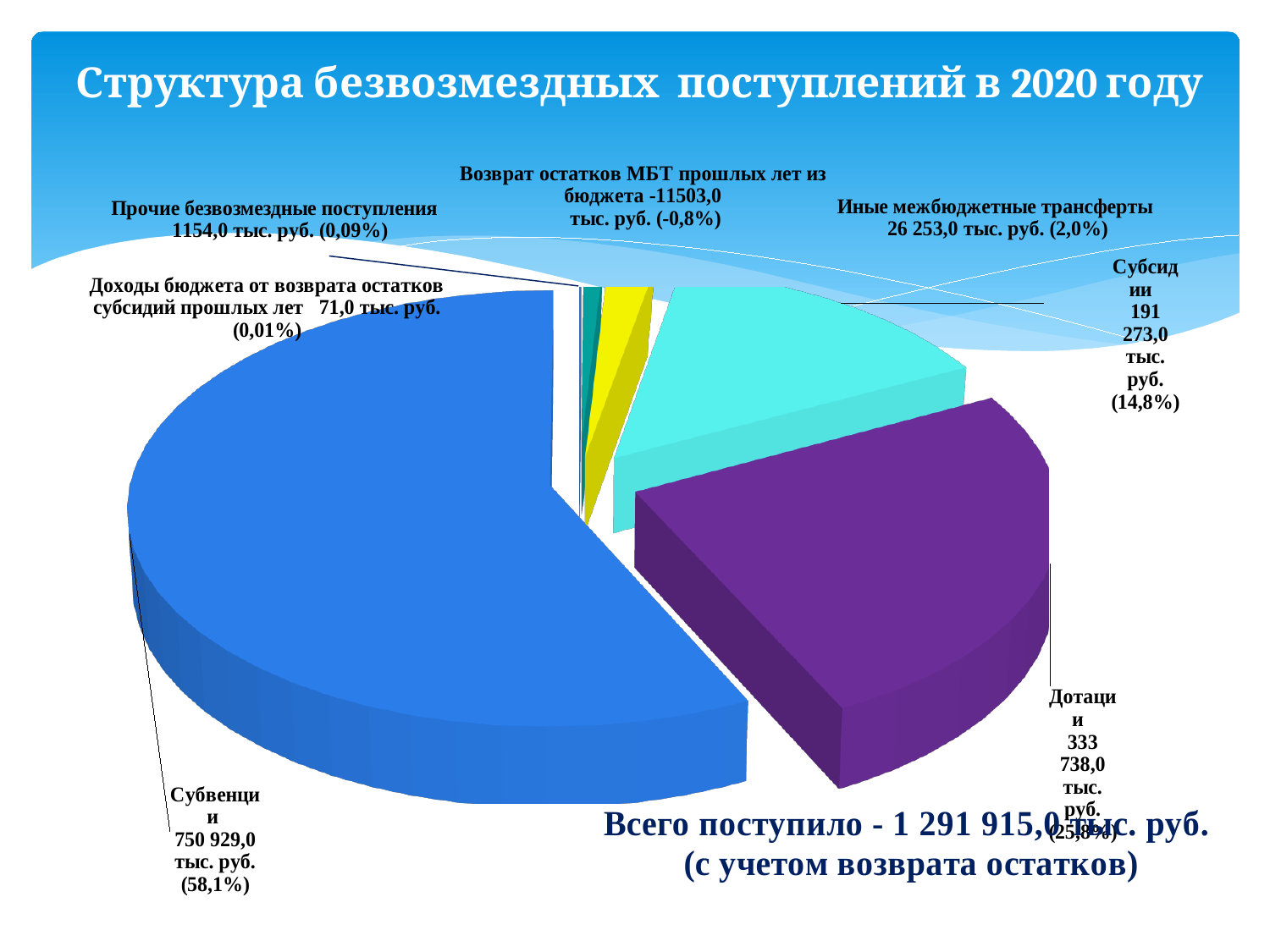
What is the value for Дотации? 333 738,0 тыс. руб. What is the value for Иные межбюджетные трансферты? 26 253,0 тыс. руб. How many categories (slices) are labelled on the pie chart? 7 What is the value for Субсидии? 191 273,0 тыс. руб. What is the difference between the values for Субвенции and Дотации? 417 191,0 тыс. руб. What kind of chart is shown on the slide? pie chart Which category has the smallest positive value? Доходы бюджета от возврата остатков субсидий прошлых лет What share of the pie does Субвенции represent? 58,1% What is the title of the chart? Структура безвозмездных поступлений в 2020 году What share of the pie does Субсидии represent? 14,8% Which category has the largest value? Субвенции What is the value for Субвенции? 750 929,0 тыс. руб.